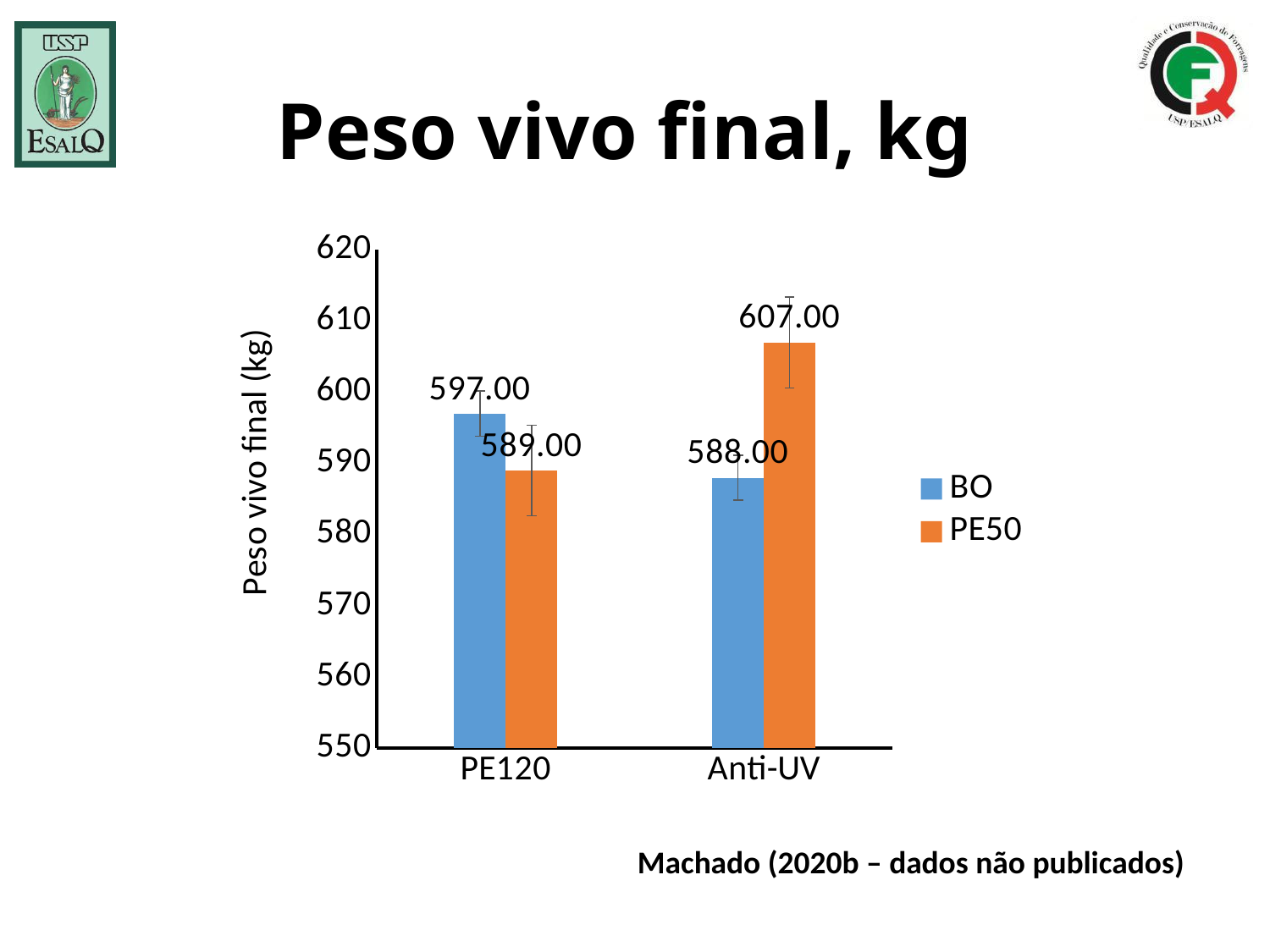
Which bar has the highest value on the chart? PE50 in Anti-UV How many series does the legend list? 2 What is the value for PE50 in the PE120 category? 589.00 What is the label of the y axis? Peso vivo final (kg) What is the value for PE50 in the Anti-UV category? 607.00 What is the difference between the PE50 and BO values in the Anti-UV category? 19.00 Which bar has the lowest value on the chart? BO in Anti-UV What kind of chart is shown on the slide? Bar chart What is the value for BO in the Anti-UV category? 588.00 In the PE120 category, which series has the larger value, BO or PE50? BO What is the difference between the BO and PE50 values in the PE120 category? 8.00 What is the value for BO in the PE120 category? 597.00